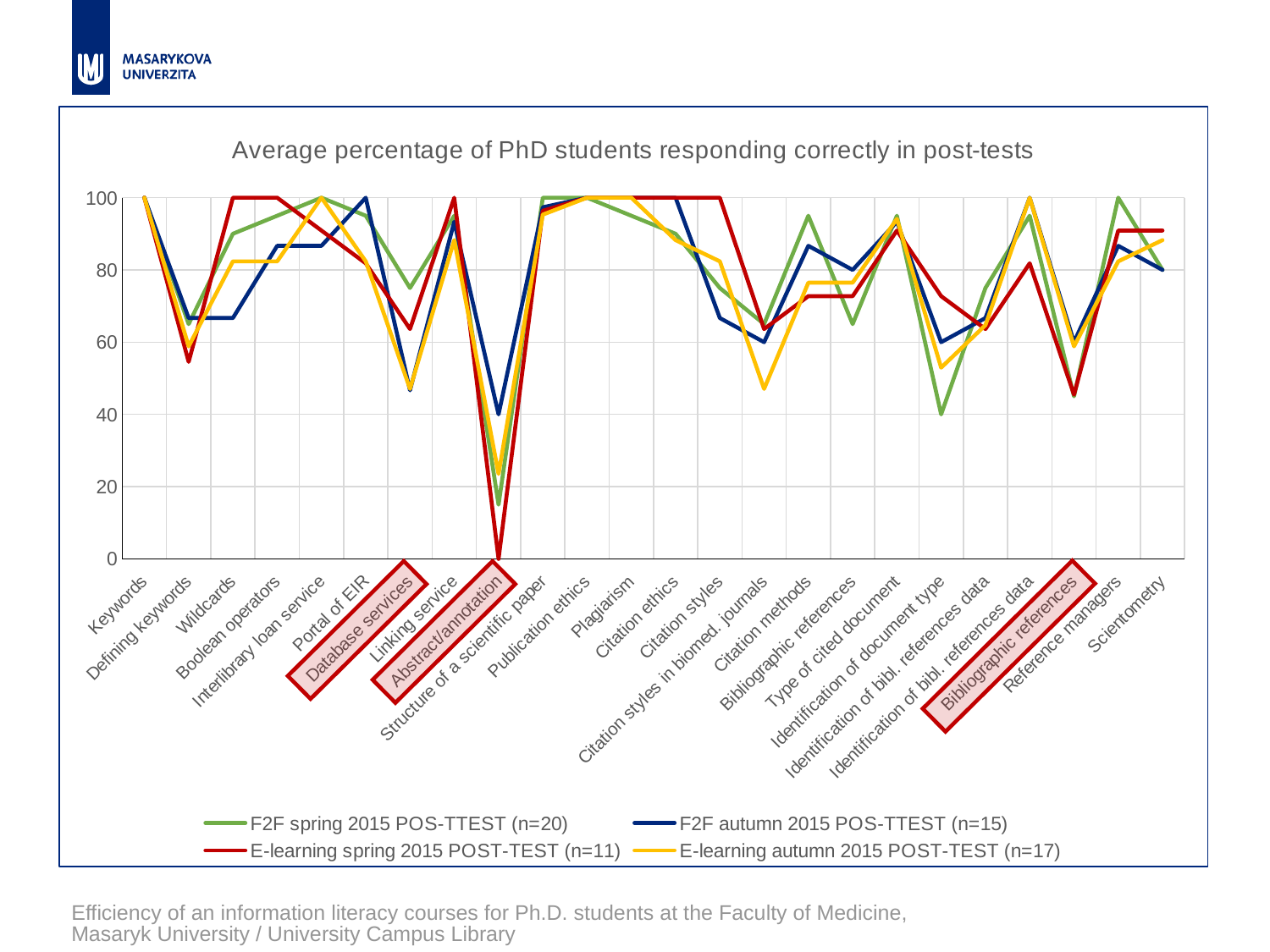
What is the title of the chart? Average percentage of PhD students responding correctly in post-tests What is the value for Abstract/annotation in the E-learning spring 2015 POST-TEST (n=11) series? 0 What is the value for Publication ethics in the E-learning autumn 2015 POST-TEST (n=17) series? 100 In the E-learning spring 2015 POST-TEST (n=11) series, which is larger: the value for Keywords or the value for Abstract/annotation? Keywords Which series in the legend has n=17? E-learning autumn 2015 POST-TEST (n=17) How many series does the legend list? 4 What is the value for Keywords in the F2F spring 2015 POS-TTEST (n=20) series? 100 Is the value for Defining keywords in the E-learning spring 2015 POST-TEST (n=11) series greater or less than 60? less For the E-learning spring 2015 POST-TEST (n=11) series, which category has the lowest value? Abstract/annotation Is the value for Abstract/annotation in the F2F spring 2015 POS-TTEST (n=20) series greater or less than 40? less What kind of chart is shown on the slide? line chart Is the value for Citation styles in biomed. journals in the E-learning autumn 2015 POST-TEST (n=17) series greater or less than 60? less